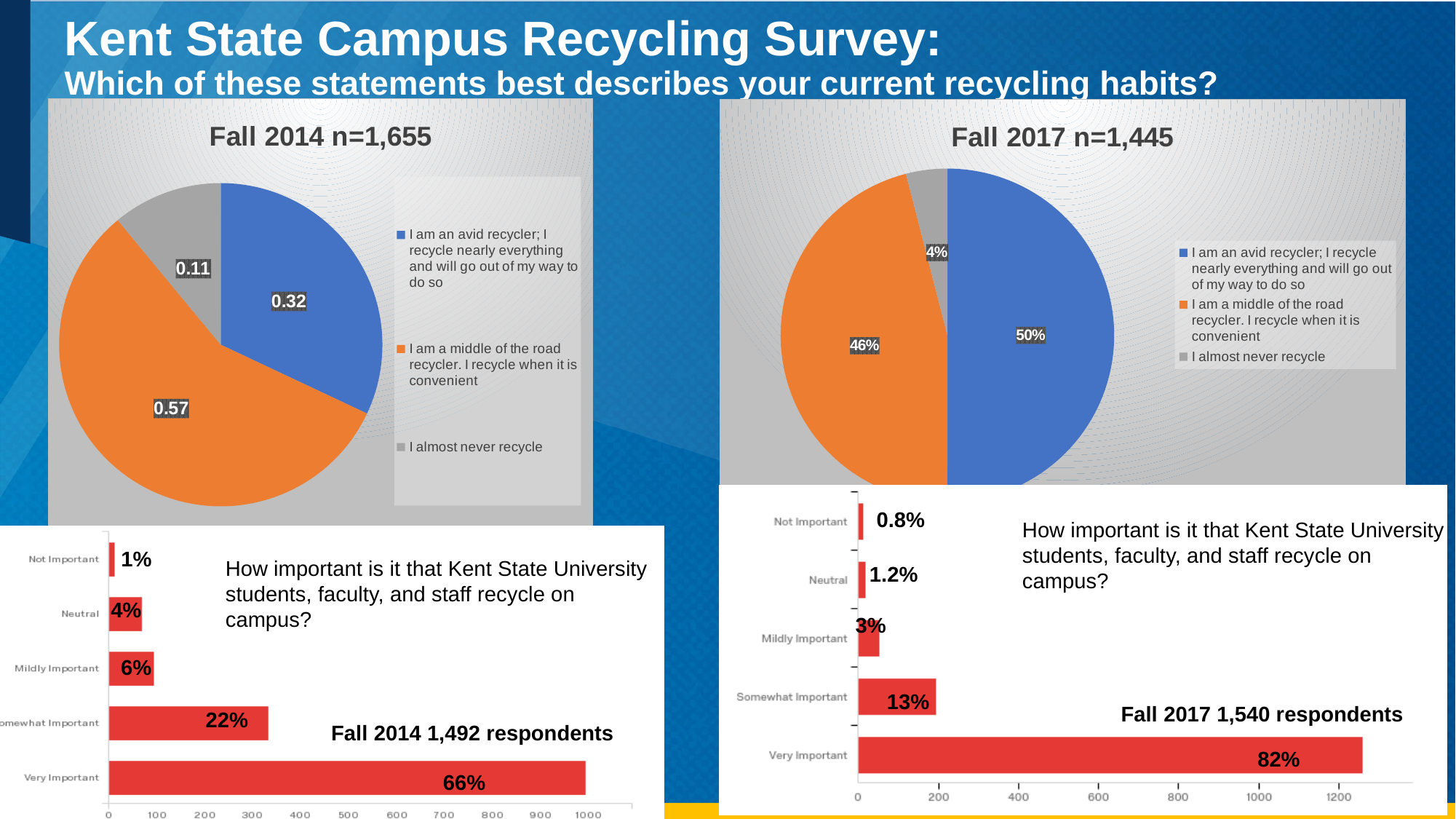
In the Fall 2017 1,540 respondents bar chart, is the bar for Very Important greater or less than 1200 on the axis? greater What kind of chart is the Fall 2014 1,492 respondents chart at the bottom left? bar chart In the Fall 2017 n=1,445 pie chart, which category has the largest slice? I am an avid recycler; I recycle nearly everything and will go out of my way to do so In the Fall 2017 n=1,445 pie chart, what percentage is shown for "I almost never recycle"? 4% In the Fall 2014 1,492 respondents bar chart, what percentage is shown for Very Important? 66% In the Fall 2014 n=1,655 pie chart, what share is shown for "I am a middle of the road recycler. I recycle when it is convenient"? 0.57 How many categories are shown in the Fall 2017 1,540 respondents bar chart? 5 In the Fall 2017 1,540 respondents bar chart, what percentage is shown for Somewhat Important? 13% In the Fall 2014 n=1,655 pie chart, what is the difference between the middle of the road recycler share and the avid recycler share? 0.25 In the Fall 2017 1,540 respondents bar chart, what is the difference between Very Important and Somewhat Important? 69% In the Fall 2014 1,492 respondents bar chart, which is larger: Neutral or Mildly Important? Mildly Important In the Fall 2014 n=1,655 pie chart, which category has the smallest slice? I almost never recycle